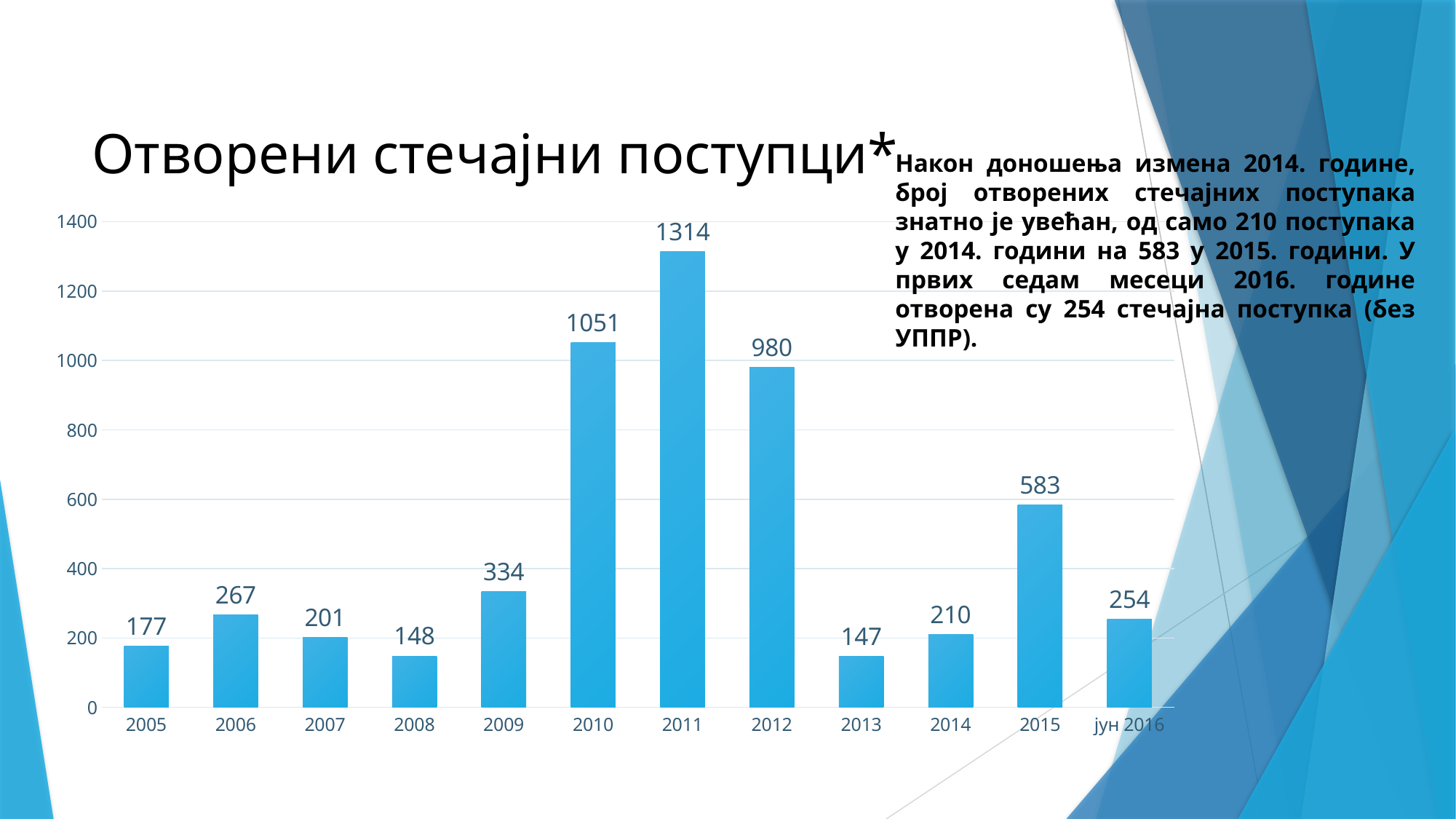
What is the value for јун 2016? 254 What is the value for 2011? 1314 What is the title of the chart? Отворени стечајни поступци* What kind of chart is shown on the slide? bar chart Which is larger, the value for 2010 or the value for 2012? 2010 What is the value for 2008? 148 What is the difference between the values for 2015 and 2014? 373 Which category has the lowest value? 2013 Which year has the highest value? 2011 How many categories are shown on the x axis? 12 Is the value for 2009 greater or less than 400? less Do the values rise or fall from 2013 to 2015? rise